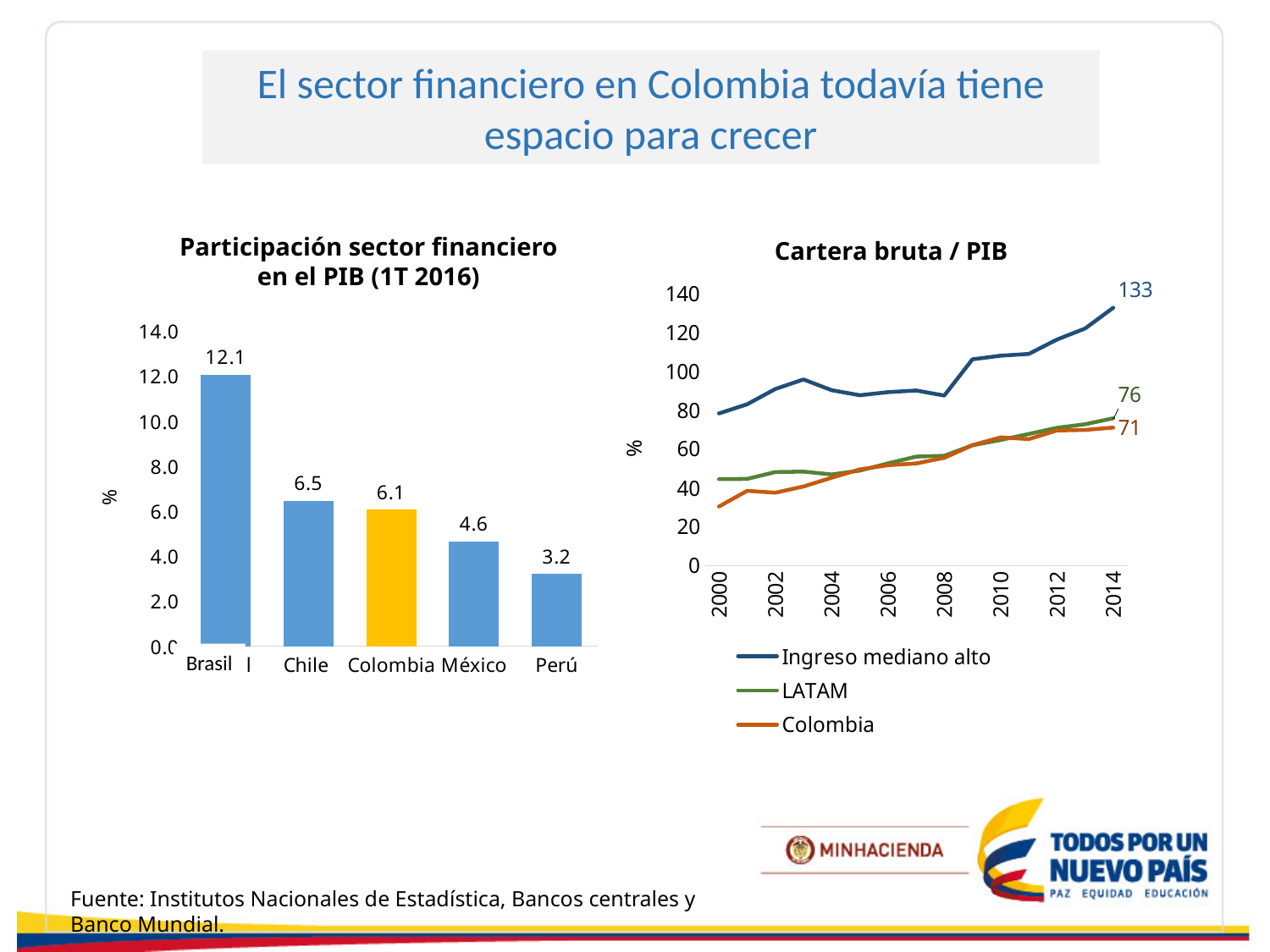
In the chart 'Participación sector financiero en el PIB (1T 2016)', what is the value for Brasil? 12.1 In the chart 'Cartera bruta / PIB', how many series does the legend list? 3 What kind of chart is 'Participación sector financiero en el PIB (1T 2016)'? Bar chart In the chart 'Cartera bruta / PIB', is the value for Ingreso mediano alto in 2000 greater or less than 60? greater In the chart 'Participación sector financiero en el PIB (1T 2016)', how many countries are shown? 5 In the chart 'Cartera bruta / PIB', what is the value labelled for Colombia in 2014? 71 In the chart 'Cartera bruta / PIB', does the Colombia line rise or fall from 2000 to 2014? Rise In the chart 'Participación sector financiero en el PIB (1T 2016)', which country has the lowest value? Perú In the chart 'Participación sector financiero en el PIB (1T 2016)', what is the difference between the values for Brasil and Chile? 5.6 In the chart 'Participación sector financiero en el PIB (1T 2016)', which country has the highest value? Brasil In the chart 'Participación sector financiero en el PIB (1T 2016)', what is the value for Colombia? 6.1 In the chart 'Cartera bruta / PIB', what is the value labelled for Ingreso mediano alto in 2014? 133